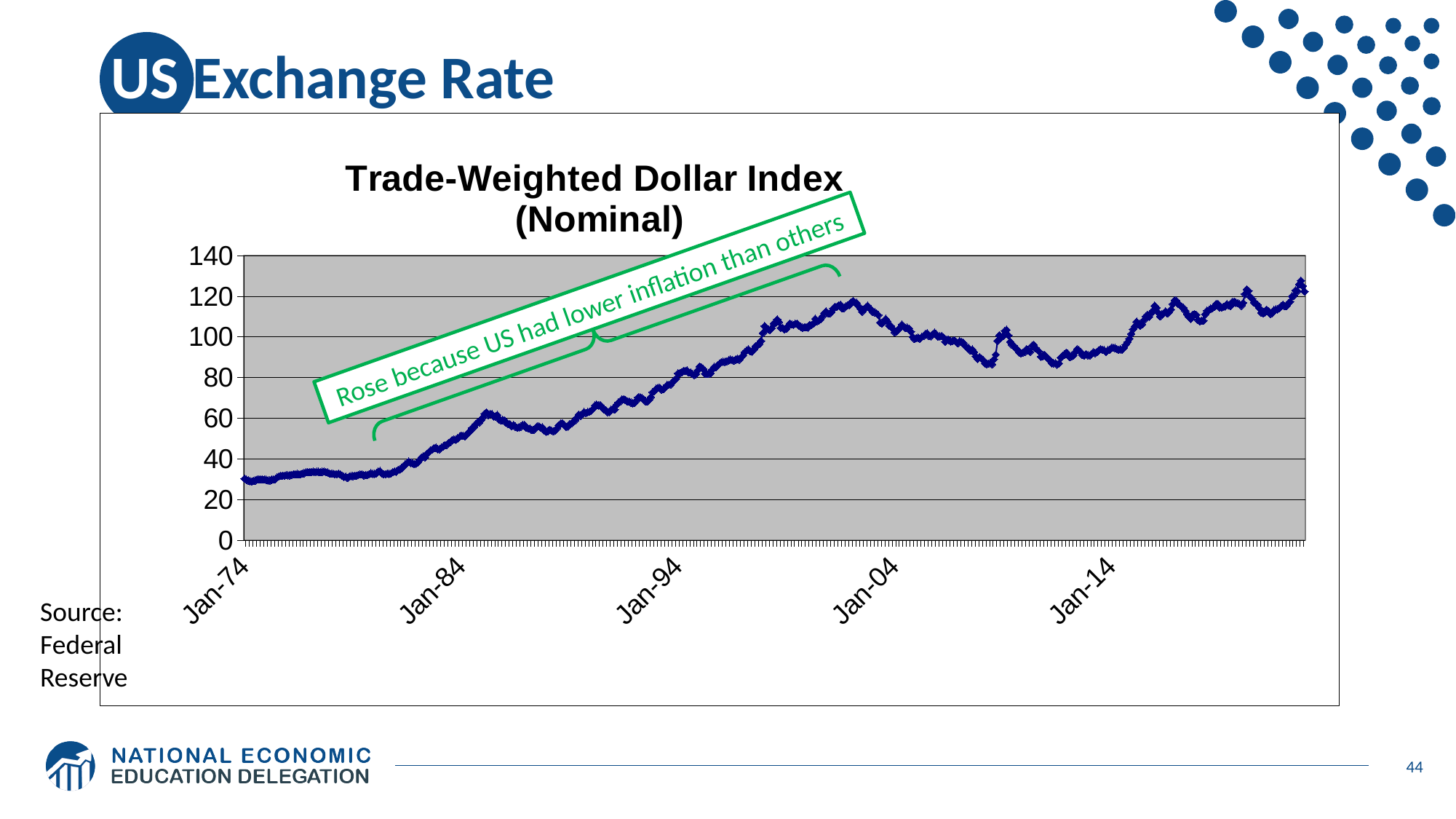
Is the value of the index at Jan-14 greater or less than 100? less Is the value of the index at Jan-74 greater or less than 40? less Is the value of the index at Jan-04 greater or less than 80? greater What is the title of the chart? Trade-Weighted Dollar Index (Nominal) Does the index rise or fall between Jan-74 and Jan-84? rise What kind of chart is shown on the slide? Line chart Overall, does the index rise or fall from Jan-74 to the end of the series? rise What does the green annotation on the chart say? Rose because US had lower inflation than others How many date labels are shown on the x axis? 5